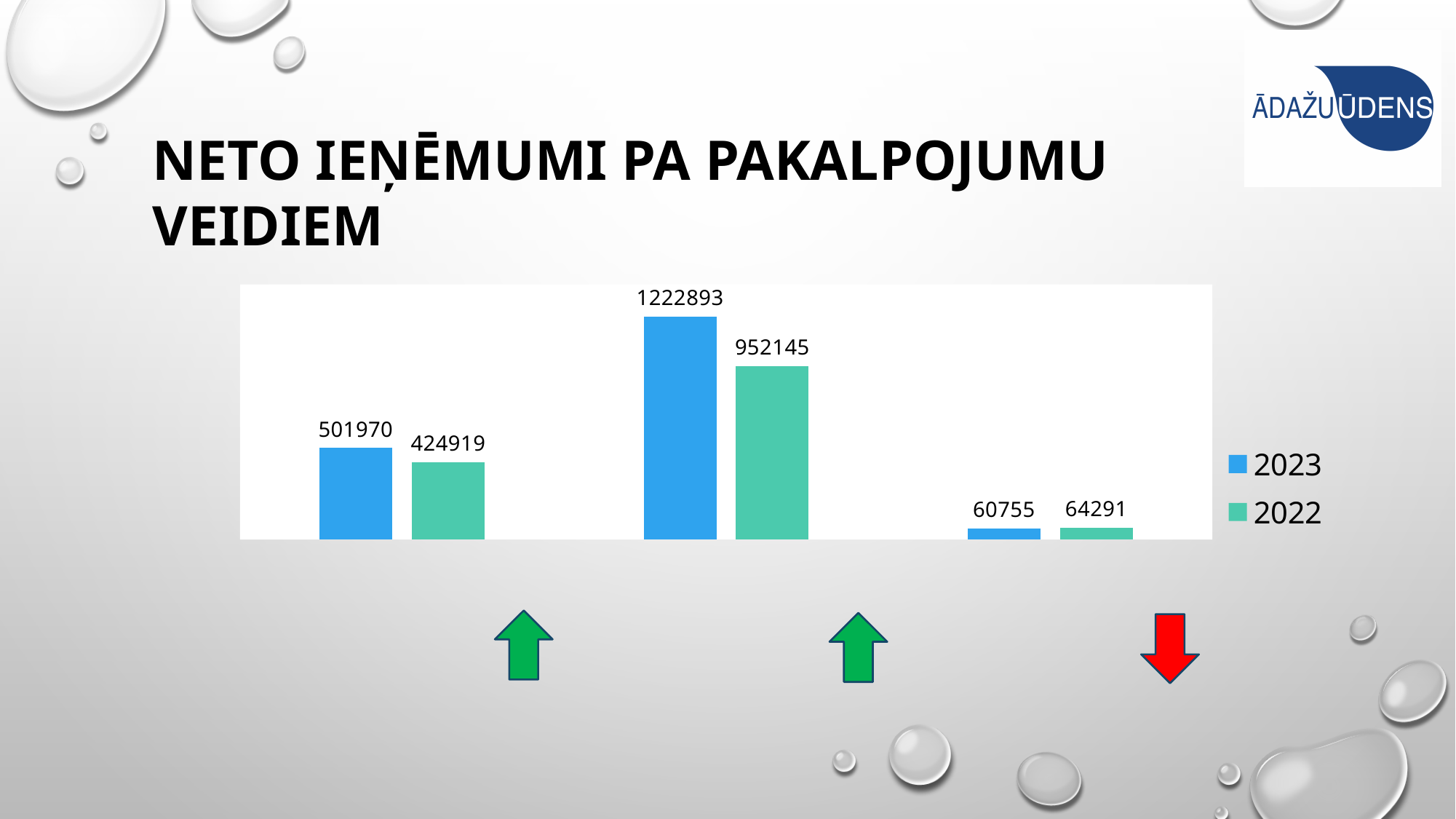
Which colour represents the 2023 series in the legend? blue Which bar has the highest value in the chart? 2023 in the middle group (1222893) What is the 2022 value for the second (middle) group of bars? 952145 Which bar has the lowest value in the chart? 2023 in the rightmost group (60755) What is the difference between the 2023 and 2022 values in the middle group of bars? 270748 How many series does the legend list? 2 What is the difference between the 2022 and 2023 values in the rightmost group of bars? 3536 What is the 2023 value for the third (rightmost) group of bars? 60755 How many groups of bars are plotted in the chart? 3 In the rightmost group of bars, which is larger: the 2023 value or the 2022 value? 2022 What type of chart is shown on the slide? bar chart What is the 2023 value for the first (leftmost) group of bars? 501970